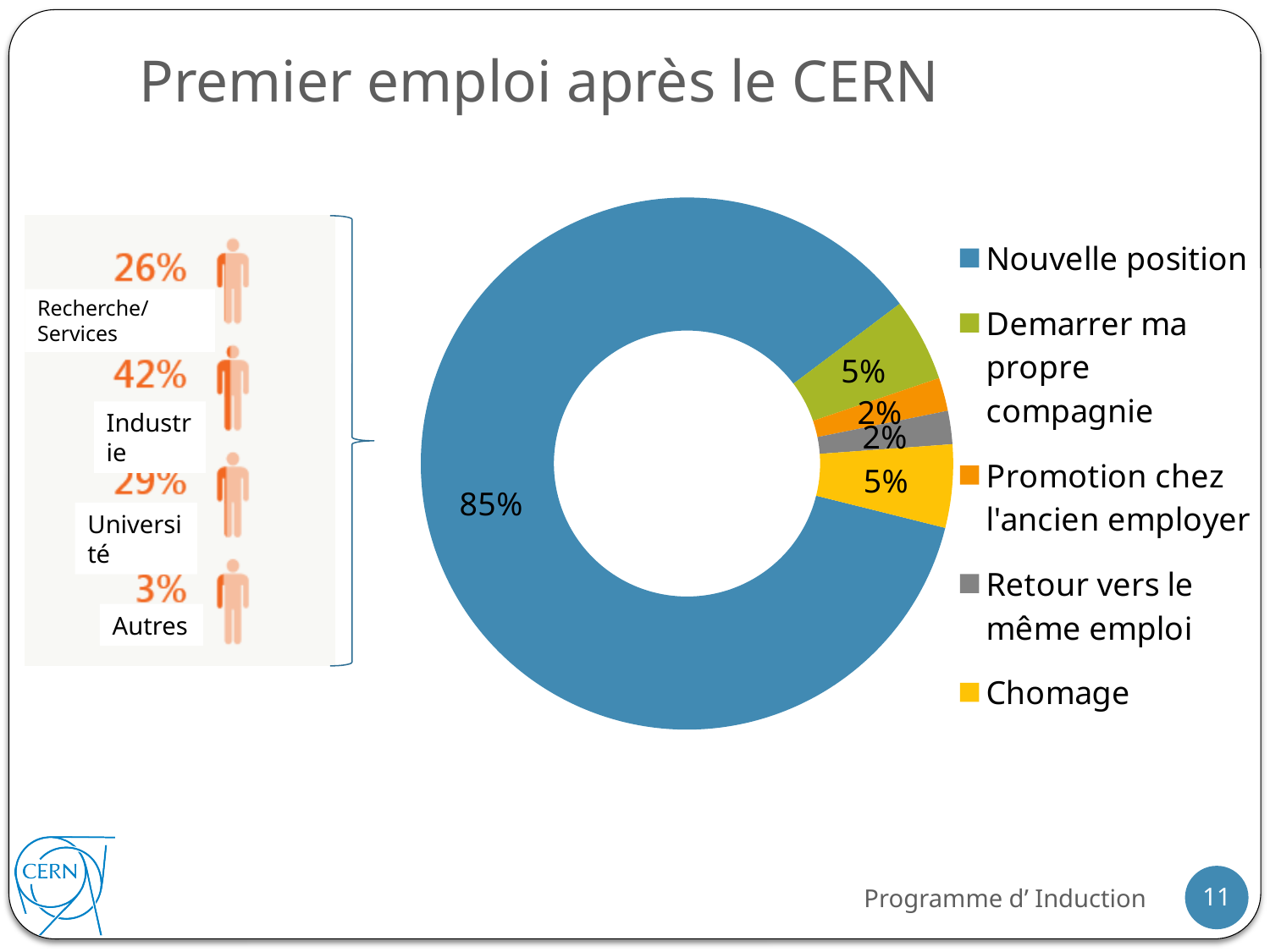
What is the difference in percentage points between 'Nouvelle position' and 'Chomage' in the doughnut chart? 80 percentage points What percentage does 'Demarrer ma propre compagnie' represent in the doughnut chart? 5% What percentage does 'Chomage' represent in the doughnut chart? 5% What colour represents 'Chomage' in the doughnut chart? Yellow Which is larger in the doughnut chart: 'Demarrer ma propre compagnie' or 'Retour vers le même emploi'? Demarrer ma propre compagnie What type of chart is shown on the slide? Doughnut (pie) chart How many slices does the doughnut chart have? 5 How many categories does the legend of the doughnut chart list? 5 What percentage of the doughnut chart is 'Nouvelle position'? 85% Which category has the largest slice in the doughnut chart? Nouvelle position What is the title of the slide containing the doughnut chart? Premier emploi après le CERN What percentage does 'Promotion chez l'ancien employer' represent in the doughnut chart? 2%